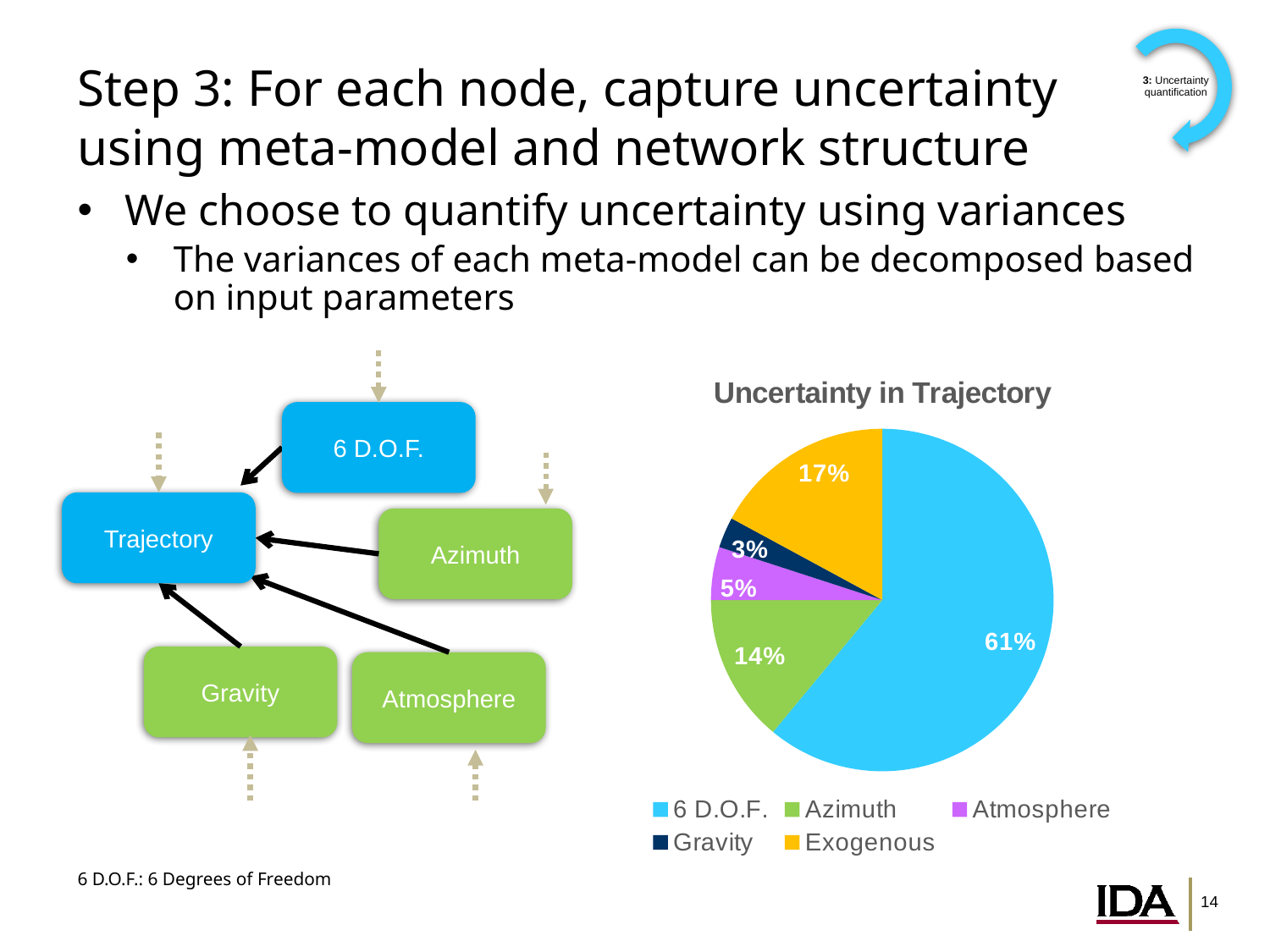
What colour is the Exogenous slice in the "Uncertainty in Trajectory" pie? Yellow Which category has the smallest slice in the "Uncertainty in Trajectory" pie? Gravity In the "Uncertainty in Trajectory" pie, what is the difference between the 6 D.O.F. share and the Exogenous share? 44% What share of the "Uncertainty in Trajectory" pie is 6 D.O.F.? 61% What share of the "Uncertainty in Trajectory" pie is Azimuth? 14% What share of the "Uncertainty in Trajectory" pie is Atmosphere? 5% What kind of chart is "Uncertainty in Trajectory"? Pie chart In the "Uncertainty in Trajectory" pie, which is larger: Azimuth or Exogenous? Exogenous Which category has the largest slice in the "Uncertainty in Trajectory" pie? 6 D.O.F. How many categories does the legend of the "Uncertainty in Trajectory" pie list? 5